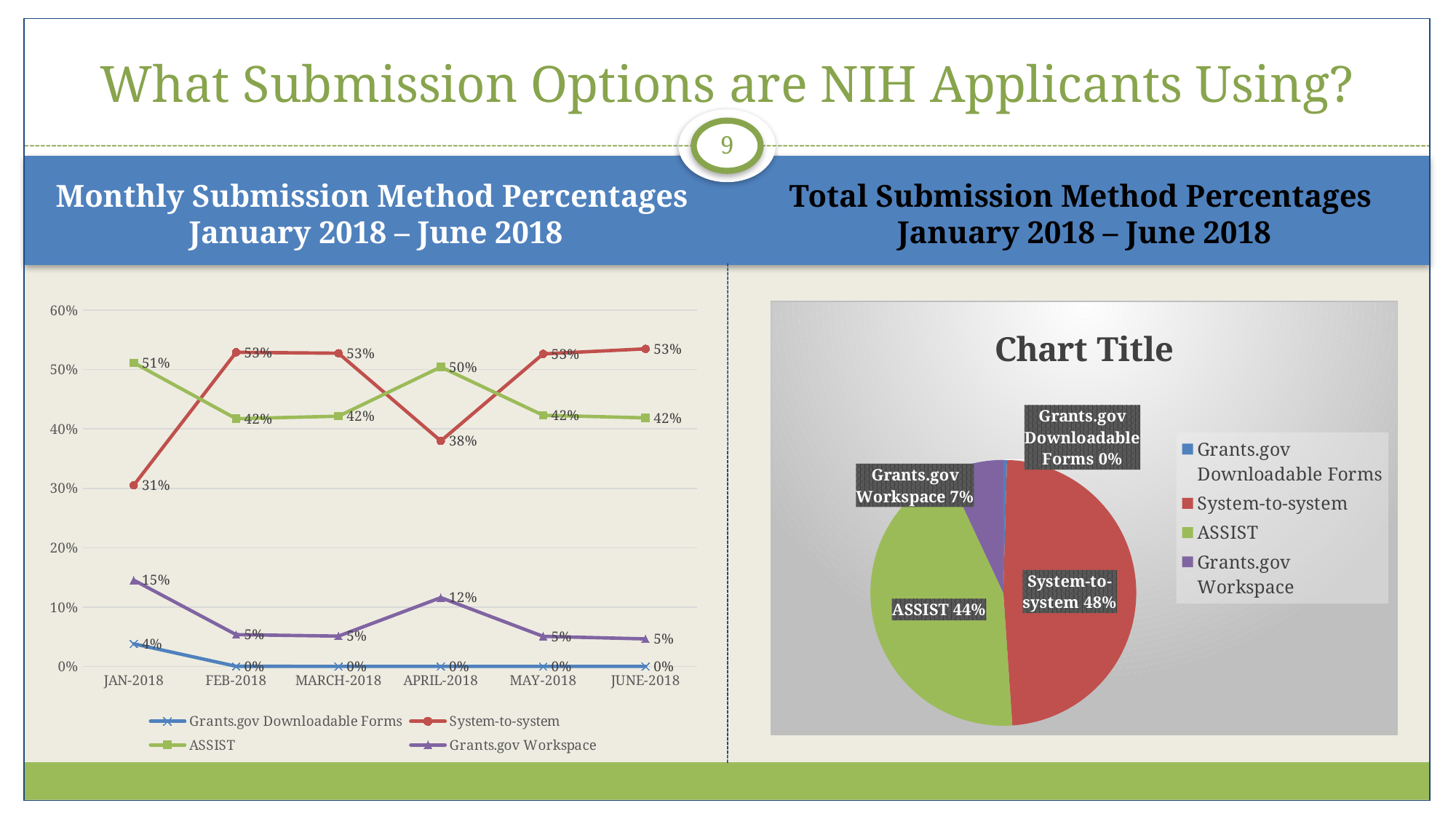
In the Total Submission Method Percentages pie chart on the right, which category has the smallest share? Grants.gov Downloadable Forms In the Monthly Submission Method Percentages line chart, what is the value for System-to-system in JAN-2018? 31% In the Monthly Submission Method Percentages line chart, how many series does the legend list? 4 In the Monthly Submission Method Percentages line chart, what is the value for ASSIST in APRIL-2018? 50% What kind of chart is the Monthly Submission Method Percentages chart on the left? Line chart In the Monthly Submission Method Percentages line chart, which series has the highest value in APRIL-2018? ASSIST What kind of chart is the Total Submission Method Percentages chart on the right? Pie chart In the Monthly Submission Method Percentages line chart, which is larger in JAN-2018: ASSIST or System-to-system? ASSIST In the Monthly Submission Method Percentages line chart, what is the difference between System-to-system and ASSIST in JUNE-2018? 11% In the Total Submission Method Percentages pie chart on the right, what share does System-to-system have? 48% In the Monthly Submission Method Percentages line chart, how many months are shown on the x axis? 6 In the Monthly Submission Method Percentages line chart, what is the value for Grants.gov Workspace in JAN-2018? 15%